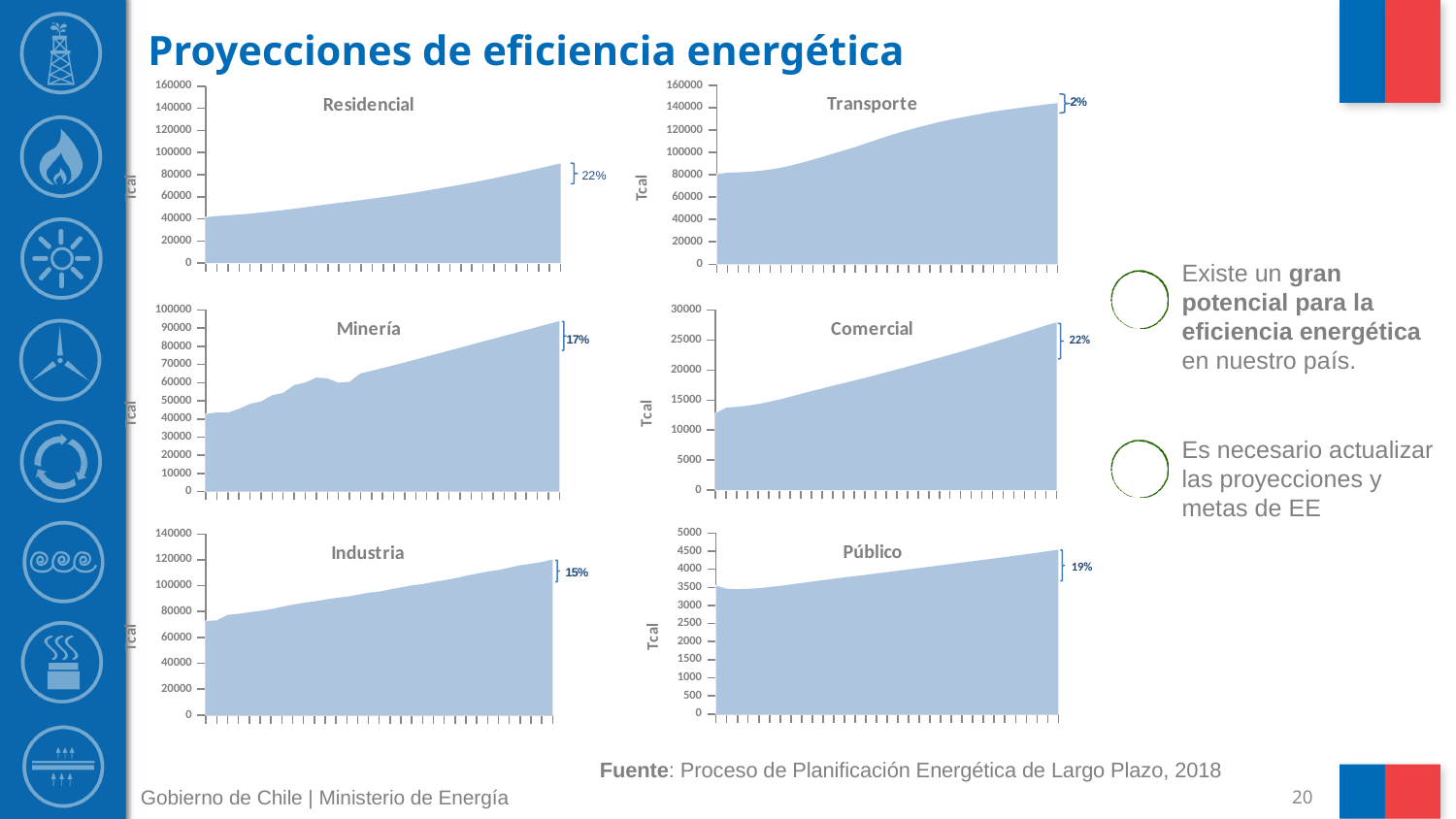
What is the highest tick value on the y axis of the Público chart? 5000 In the Residencial chart, is the first value greater or less than 60000? less What percentage is annotated at the right end of the Público chart? 19% What percentage is annotated at the right end of the Residencial chart? 22% What is the y-axis label on the Minería chart? Tcal In the Transporte chart, do the values rise or fall along the x axis? rise In the Industria chart, do the values rise or fall along the x axis? rise In the Comercial chart, is the final value greater or less than 20000? greater How many charts are shown on the slide? 6 What percentage is annotated at the right end of the Minería chart? 17% What kind of chart is the Residencial chart? area chart What percentage is annotated at the right end of the Transporte chart? 2%